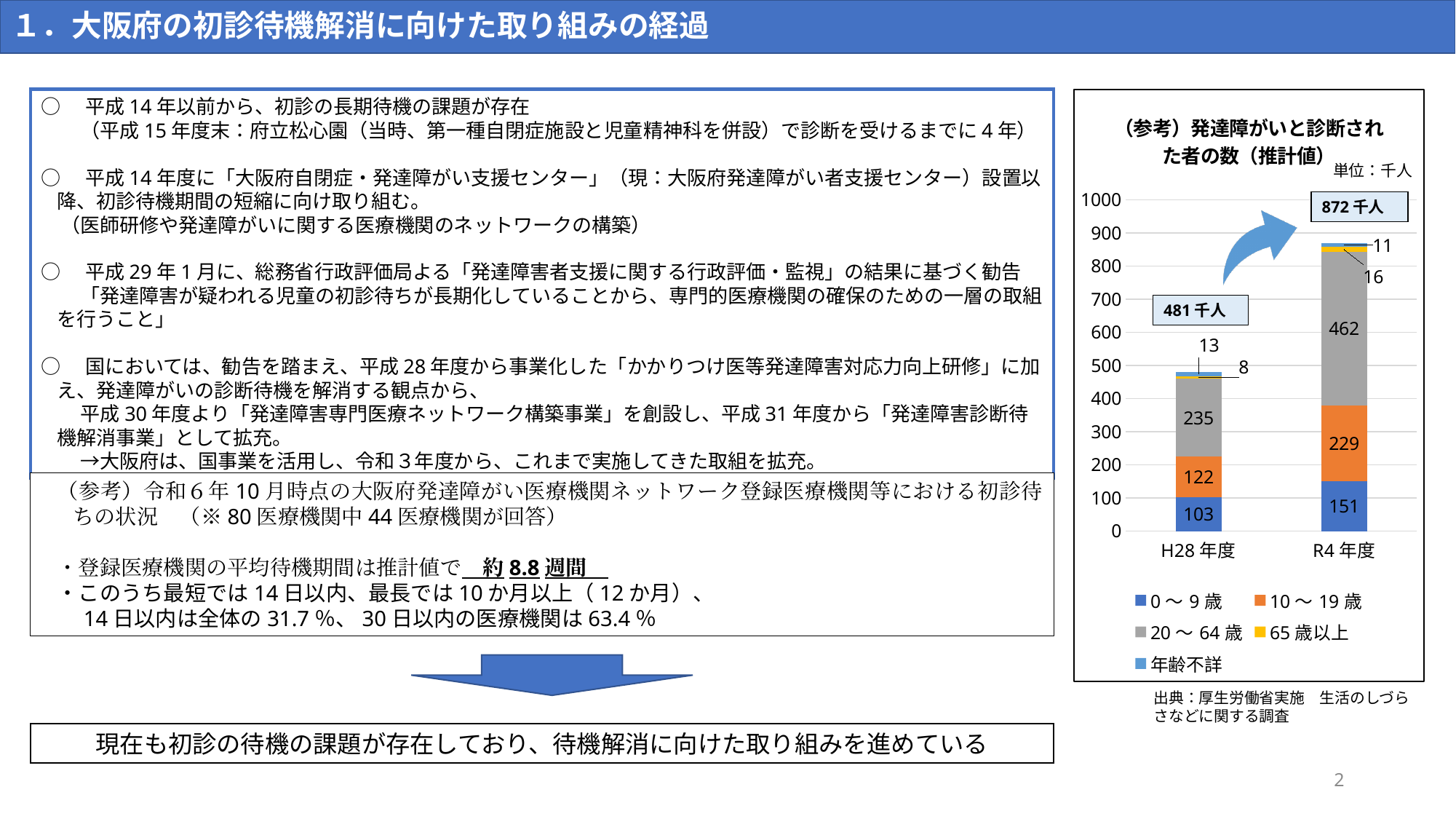
R4年度の「20～64歳」の値はいくつですか？ 462 グラフの単位は何ですか？ 千人 H28年度の積み上げ棒の合計として示されている値はいくつですか？ 481千人 R4年度の「10～19歳」の値はいくつですか？ 229 グラフの横軸にはいくつの年度が示されていますか？ 2 H28年度の「0～9歳」の値はいくつですか？ 103 R4年度の積み上げ棒の合計として示されている値はいくつですか？ 872千人 H28年度の「10～19歳」とR4年度の「10～19歳」では、どちらの値が大きいですか？ R4年度 「20～64歳」の値は、H28年度とR4年度でどれだけ増えましたか？ 227 H28年度の棒の合計は500より大きいですか、小さいですか？ 小さい グラフ「（参考）発達障がいと診断された者の数（推計値）」はどの種類のグラフですか？ 積み上げ棒グラフ グラフの凡例にはいくつの系列がありますか？ 5